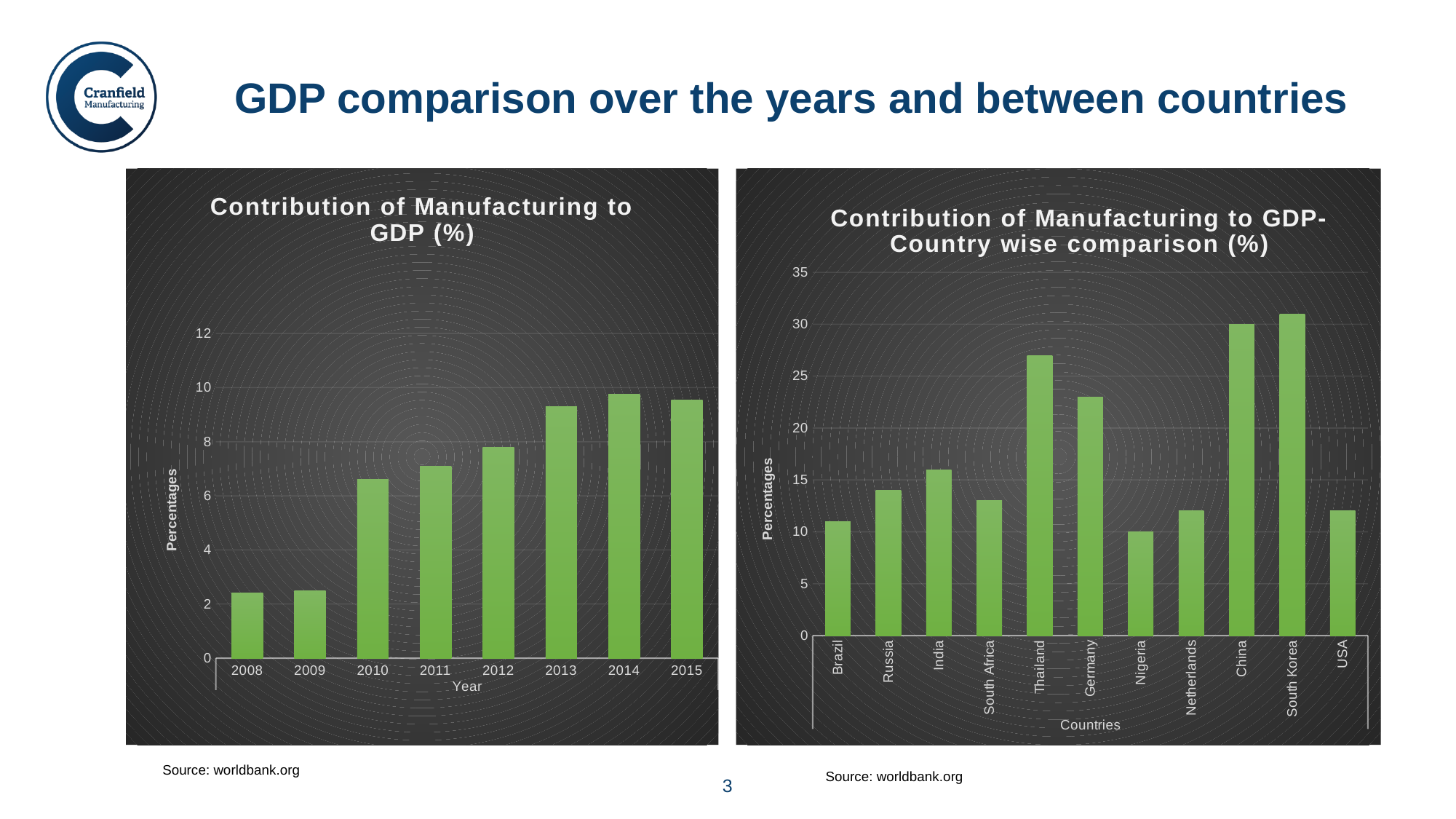
In the right chart, 'Contribution of Manufacturing to GDP- Country wise comparison (%)', is the value for Nigeria greater or less than 15? less In the left chart, 'Contribution of Manufacturing to GDP (%)', is the value for 2013 greater or less than 8? greater What kind of chart is the left chart, 'Contribution of Manufacturing to GDP (%)'? bar chart In the right chart, 'Contribution of Manufacturing to GDP- Country wise comparison (%)', which is larger, the value for China or the value for Brazil? China In the right chart, 'Contribution of Manufacturing to GDP- Country wise comparison (%)', which is larger, the value for Thailand or the value for Germany? Thailand How many years are shown on the x axis of the left chart, 'Contribution of Manufacturing to GDP (%)'? 8 What is the x-axis label of the right chart, 'Contribution of Manufacturing to GDP- Country wise comparison (%)'? Countries In the left chart, 'Contribution of Manufacturing to GDP (%)', which is larger, the value for 2010 or the value for 2013? 2013 In the left chart, 'Contribution of Manufacturing to GDP (%)', do the values generally rise or fall from 2008 to 2015? rise How many countries are shown in the right chart, 'Contribution of Manufacturing to GDP- Country wise comparison (%)'? 11 In the right chart, 'Contribution of Manufacturing to GDP- Country wise comparison (%)', is the value for Thailand greater or less than 25? greater